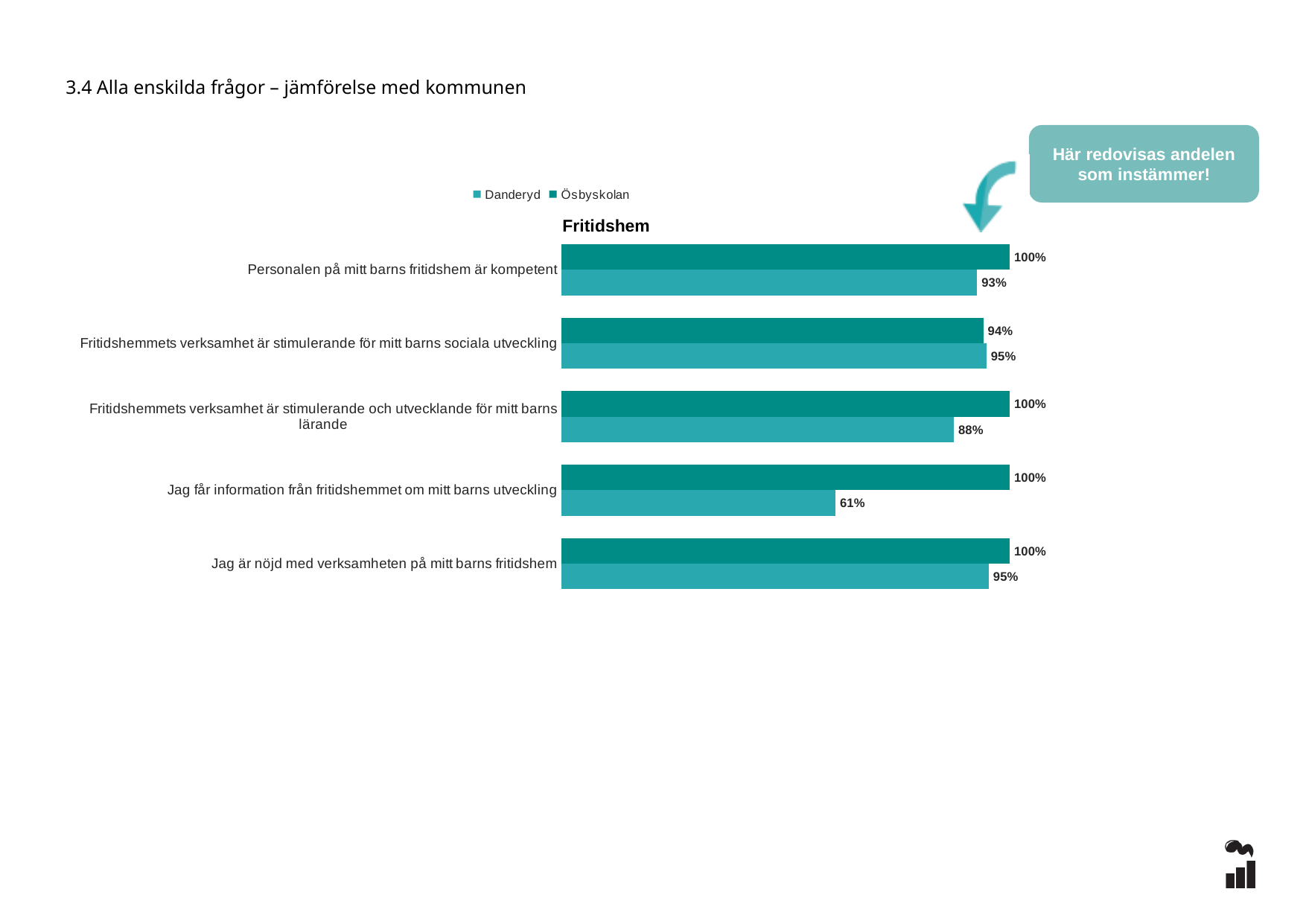
How many series does the legend list? 2 What type of chart is shown on the slide? Bar chart For "Fritidshemmets verksamhet är stimulerande för mitt barns sociala utveckling", which is higher: Danderyd or Ösbyskolan? Danderyd Which statement has the lowest Danderyd value? Jag får information från fritidshemmet om mitt barns utveckling What is the difference between the Ösbyskolan and Danderyd values for "Jag får information från fritidshemmet om mitt barns utveckling"? 39 percentage points What is the Danderyd value for "Fritidshemmets verksamhet är stimulerande och utvecklande för mitt barns lärande"? 88% What is the Ösbyskolan value for "Fritidshemmets verksamhet är stimulerande för mitt barns sociala utveckling"? 94% How many statements (categories) are shown in the chart? 5 What is the Ösbyskolan value for "Personalen på mitt barns fritidshem är kompetent"? 100% What is the difference between the Ösbyskolan and Danderyd values for "Personalen på mitt barns fritidshem är kompetent"? 7 percentage points For "Jag är nöjd med verksamheten på mitt barns fritidshem", which is higher: Danderyd or Ösbyskolan? Ösbyskolan What is the Danderyd value for "Jag får information från fritidshemmet om mitt barns utveckling"? 61%